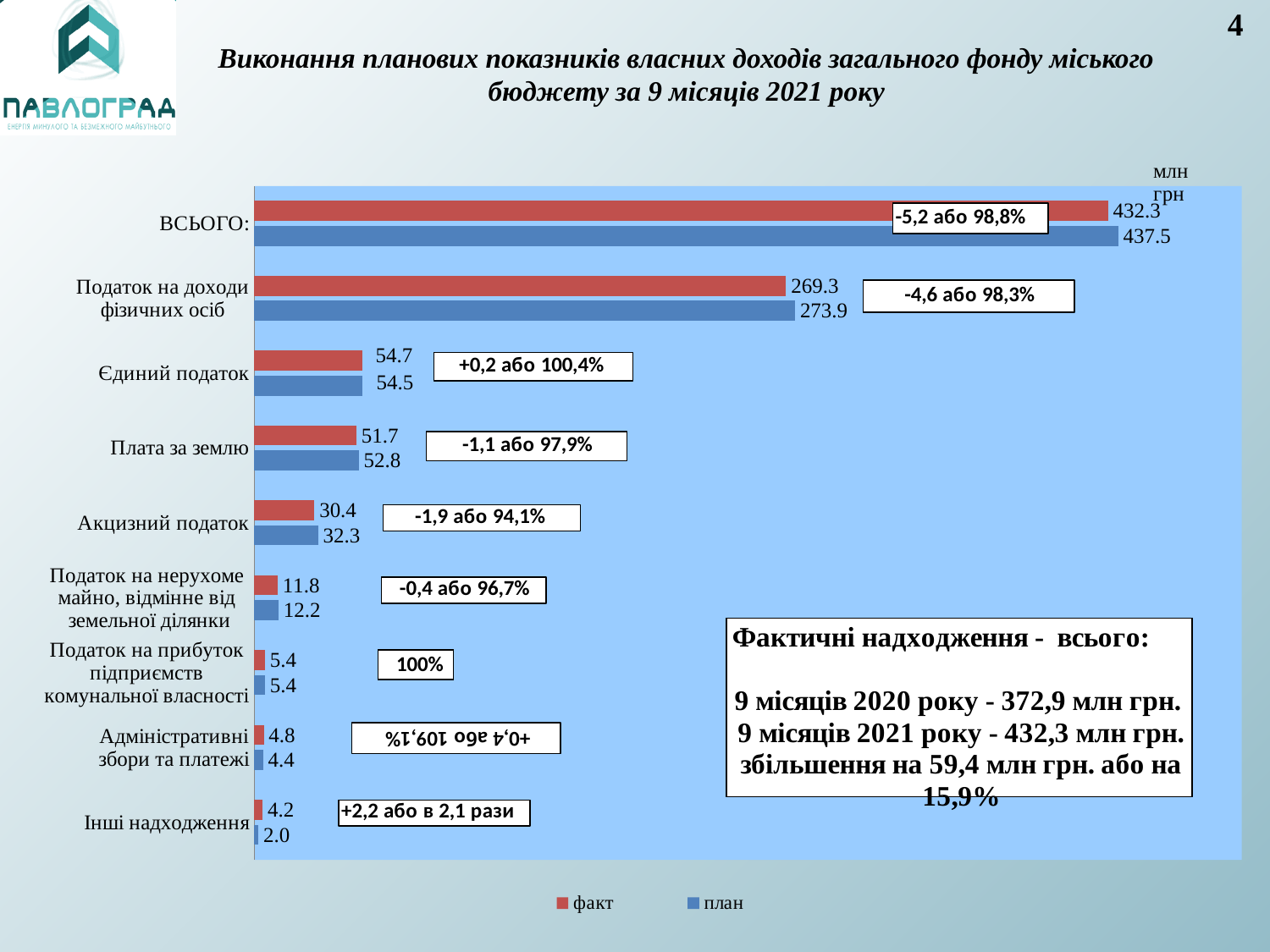
What is the план value for Інші надходження? 2.0 What is the факт value for ВСЬОГО? 432.3 What is the план value for Акцизний податок? 32.3 What is the difference between the план and факт values for Податок на доходи фізичних осіб? 4.6 What kind of chart is shown on the slide? bar chart Which is larger for Плата за землю, the факт value or the план value? план What is the факт value for Єдиний податок? 54.7 How many series does the legend list? 2 Which category has the lowest план value? Інші надходження How many categories are shown on the chart? 9 Which colour represents the факт series in the chart? red Excluding the ВСЬОГО total, which category has the highest факт value? Податок на доходи фізичних осіб